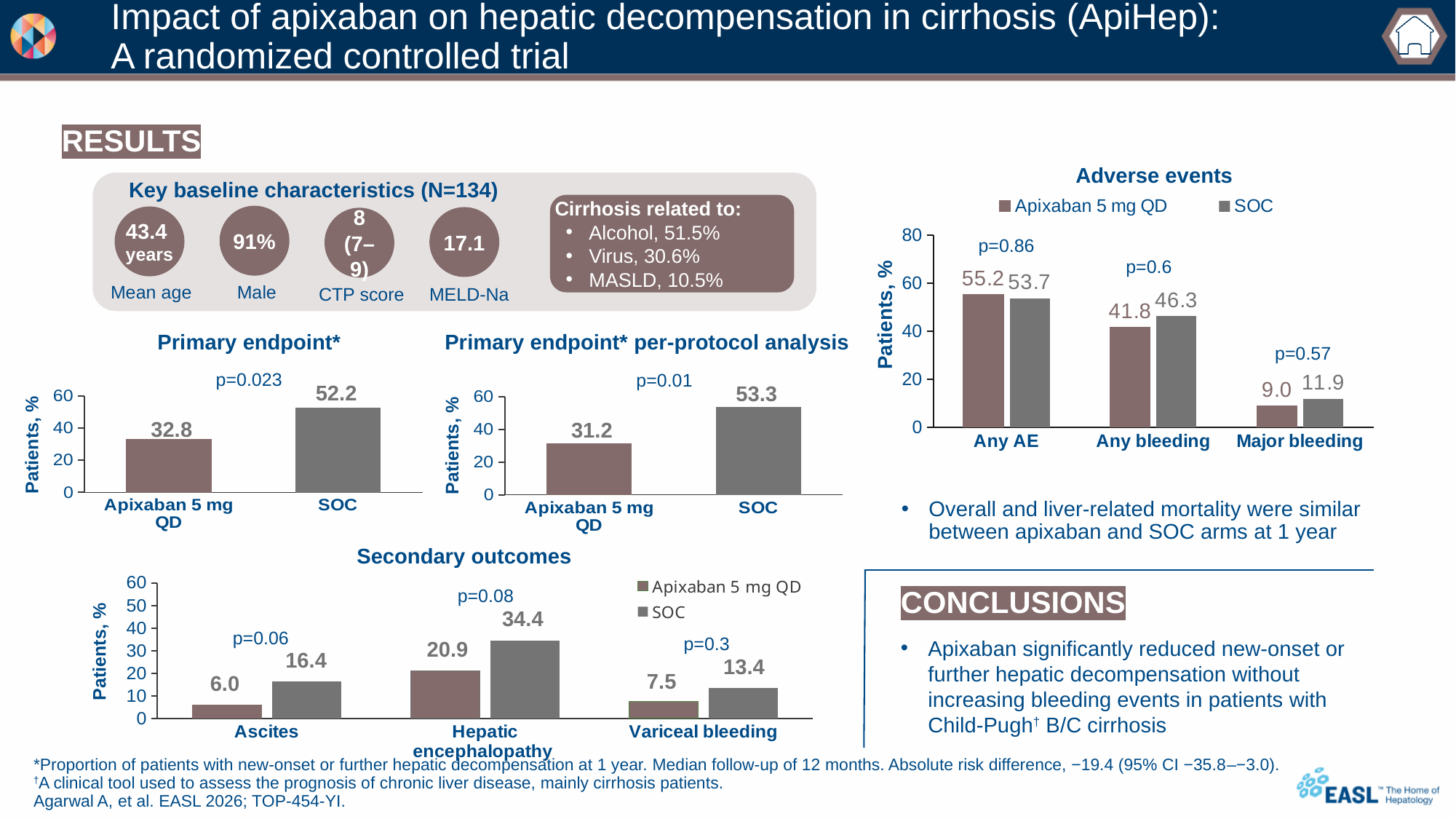
In the 'Primary endpoint*' chart, what is the value for Apixaban 5 mg QD? 32.8 In the 'Adverse events' chart, what is the Apixaban 5 mg QD value for Any bleeding? 41.8 In the 'Adverse events' chart, which category has the highest SOC value? Any AE What type of chart is the 'Adverse events' chart? Bar chart In the 'Secondary outcomes' chart, how many categories are shown on the x axis? 3 In the 'Adverse events' chart, how many series does the legend list? 2 In the 'Secondary outcomes' chart, which category has the lowest Apixaban 5 mg QD value? Ascites In the 'Primary endpoint* per-protocol analysis' chart, which group has the higher value, Apixaban 5 mg QD or SOC? SOC In the 'Secondary outcomes' chart, what is the difference between the SOC and Apixaban 5 mg QD values for Variceal bleeding? 5.9 In the 'Primary endpoint* per-protocol analysis' chart, what is the value for SOC? 53.3 In the 'Secondary outcomes' chart, what is the SOC value for Hepatic encephalopathy? 34.4 In the 'Primary endpoint*' chart, what is the difference between the SOC and Apixaban 5 mg QD values? 19.4